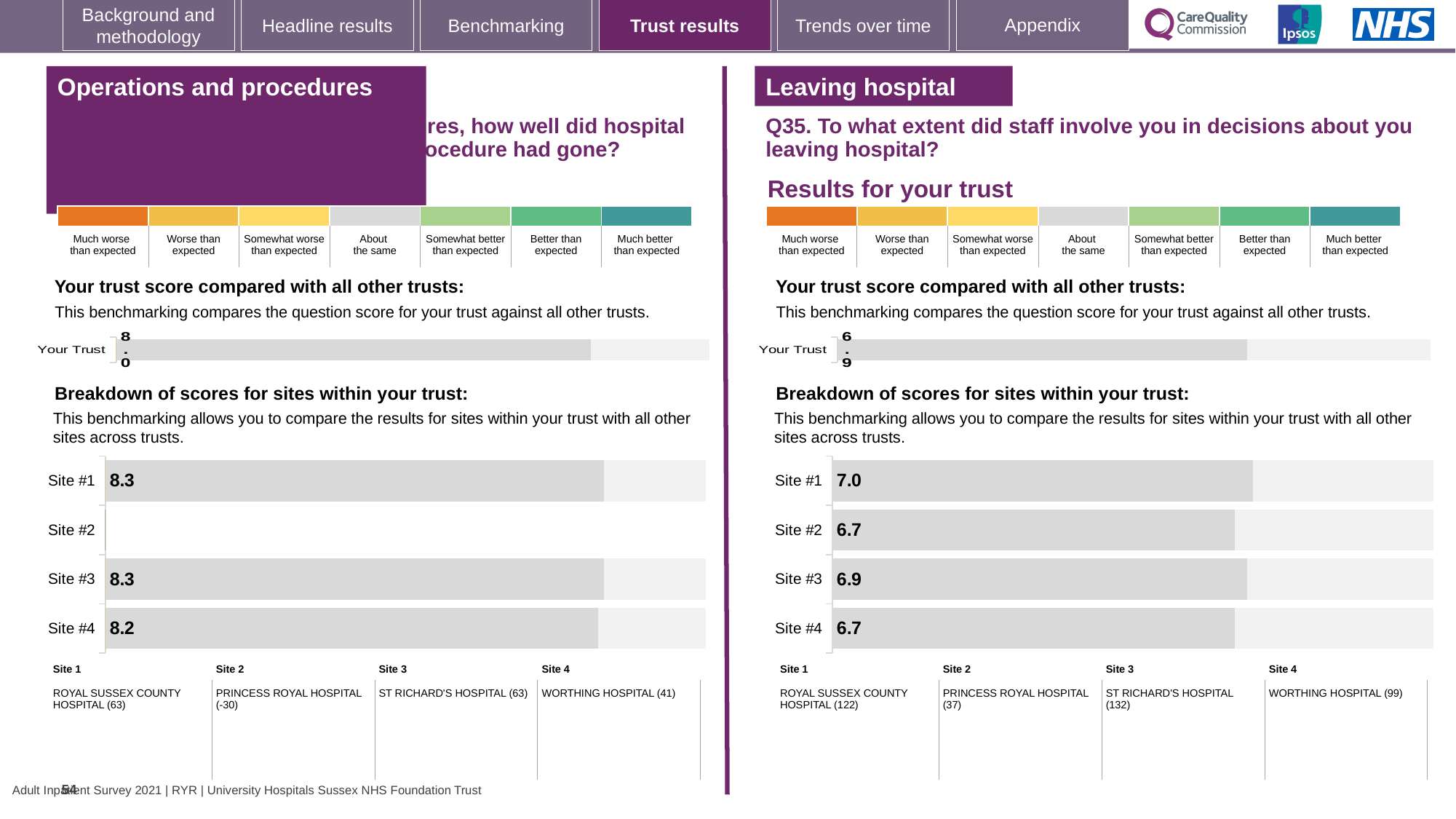
In the Leaving hospital site breakdown chart, what is the score for Site #1? 7.0 In the Operations and procedures site breakdown chart, what is the difference between the scores for Site #3 and Site #4? 0.1 In the Operations and procedures 'Your trust score compared with all other trusts' chart, what is the score for Your Trust? 8.0 In the Leaving hospital site breakdown chart, which is larger, the score for Site #3 or the score for Site #4? Site #3 In the Leaving hospital site breakdown chart, which site has the highest score? Site #1 How many sites are listed in the Leaving hospital site breakdown chart? 4 In the Leaving hospital site breakdown chart, what is the difference between the scores for Site #1 and Site #2? 0.3 In the Operations and procedures site breakdown chart, what is the score for Site #1? 8.3 In the Leaving hospital site breakdown chart, what is the score for Site #3? 6.9 In the Leaving hospital 'Your trust score compared with all other trusts' chart, what is the score for Your Trust? 6.9 In the Operations and procedures site breakdown chart, what is the score for Site #4? 8.2 What kind of chart is the Leaving hospital site breakdown chart? Bar chart